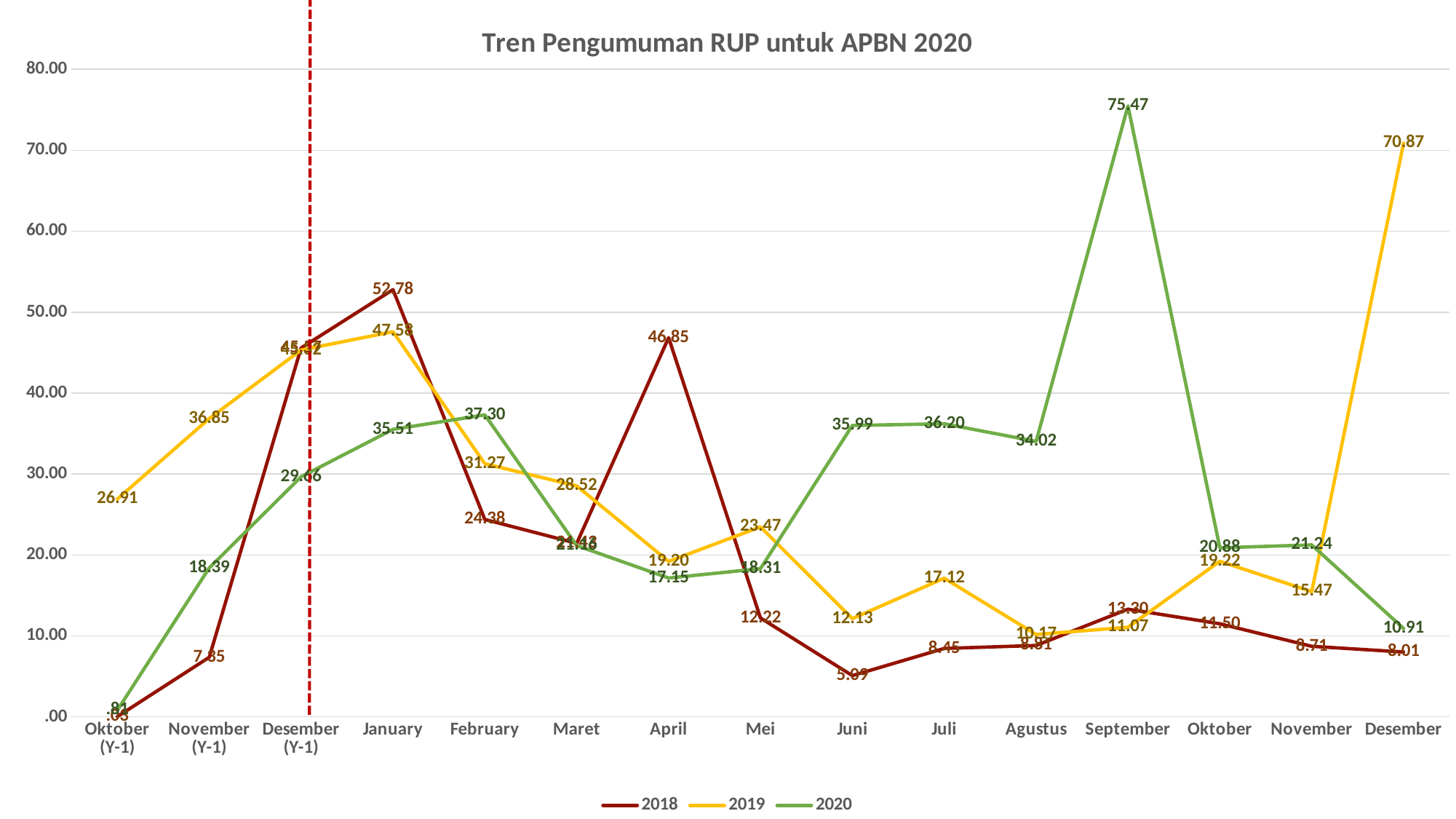
Which series has the larger value in April, 2018 or 2019? 2018 In which month does the 2018 series reach its highest value? January What kind of chart is shown on the slide? Line chart What is the value for 2020 in September? 75.47 What is the value for 2019 in November (Y-1)? 36.85 Is the value for 2020 in Juni greater or less than 30.00? greater What is the value for 2019 in Desember? 70.87 In which month does the 2020 series reach its highest value? September What is the difference between the 2018 and 2019 values in January? 5.20 What is the difference between the 2019 and 2020 values in Desember? 59.96 How many series does the legend list? 3 What is the value for 2018 in April? 46.85